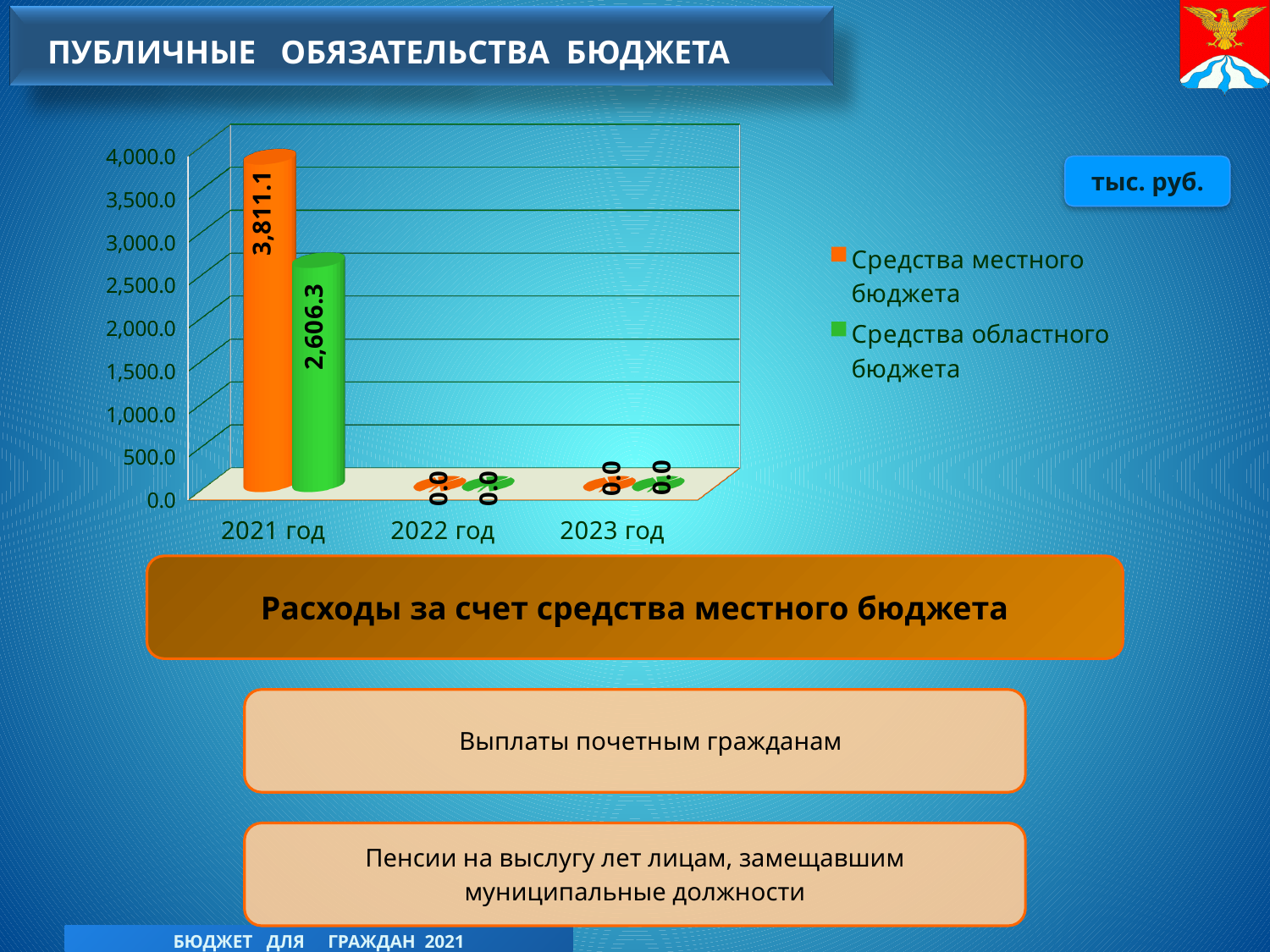
What is the value for Средства местного бюджета in 2021 год? 3,811.1 How many years are shown on the x axis of the chart? 3 What is the value for Средства областного бюджета in 2023 год? 0.0 What is the value for Средства областного бюджета in 2021 год? 2,606.3 What is the value for Средства местного бюджета in 2022 год? 0.0 How many series does the chart legend list? 2 What unit is indicated for the chart values? тыс. руб. Is the value for Средства областного бюджета in 2021 год greater or less than 3,000.0? less What is the difference between Средства местного бюджета and Средства областного бюджета in 2021 год? 1,204.8 What kind of chart is shown on the slide? bar chart Which year has the highest value for Средства местного бюджета? 2021 год In 2021 год, which is larger: Средства местного бюджета or Средства областного бюджета? Средства местного бюджета